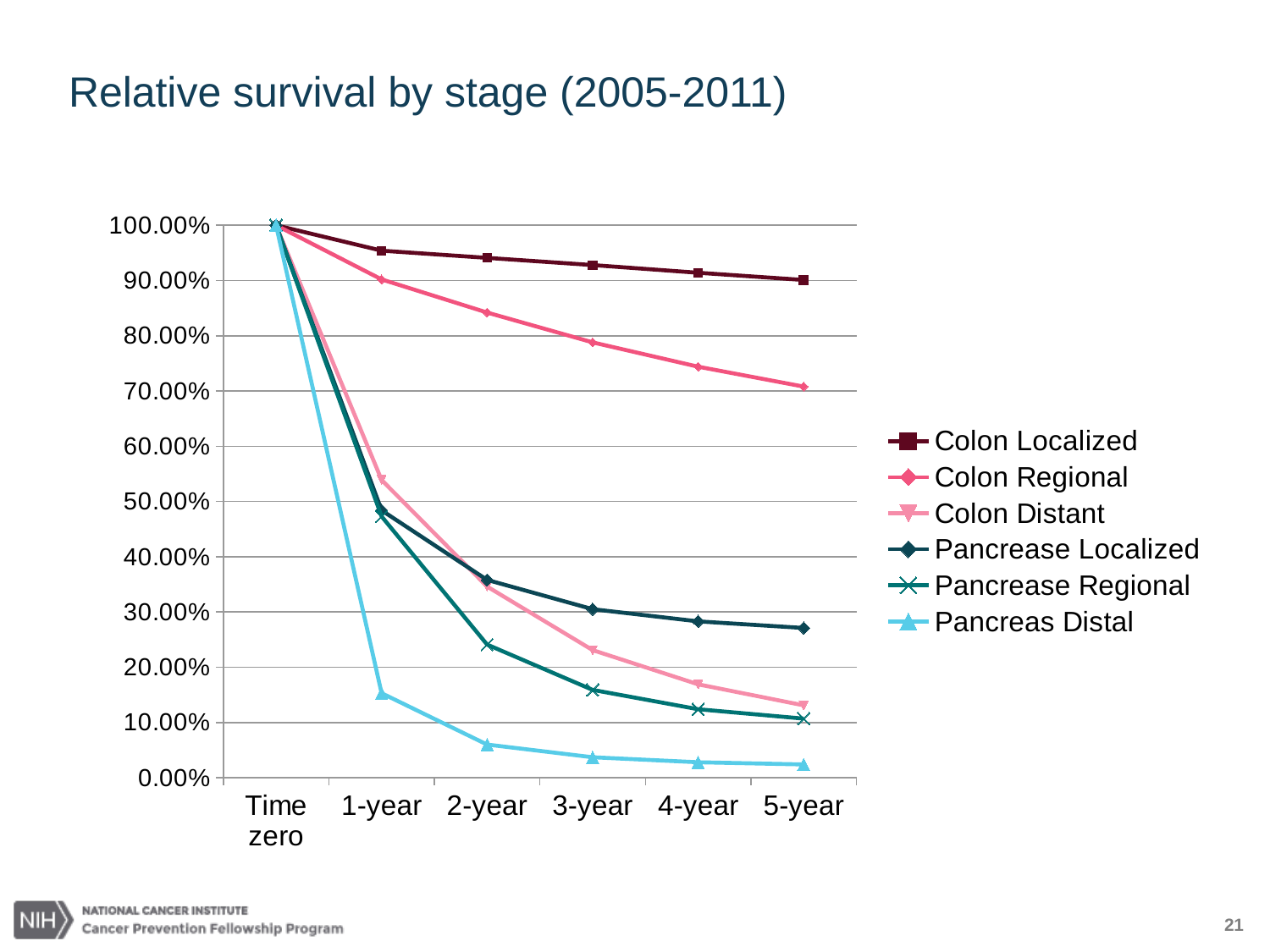
Which series has the highest relative survival at 5-year? Colon Localized What kind of chart is shown on the slide? line chart How many series does the legend list? 6 Does the Colon Regional series rise or fall from Time zero to 5-year? fall Is the value for Colon Localized at 5-year greater or less than 80.00%? greater At 3-year, which is larger: Colon Regional or Pancrease Localized? Colon Regional Is the value for Pancreas Distal at 1-year greater or less than 20.00%? less How many time points are shown along the x axis? 6 Which series has the lowest relative survival at 5-year? Pancreas Distal What is the relative survival for Colon Localized at Time zero? 100.00% Is the value for Colon Regional at 5-year greater or less than 60.00%? greater What is the title of the chart? Relative survival by stage (2005-2011)